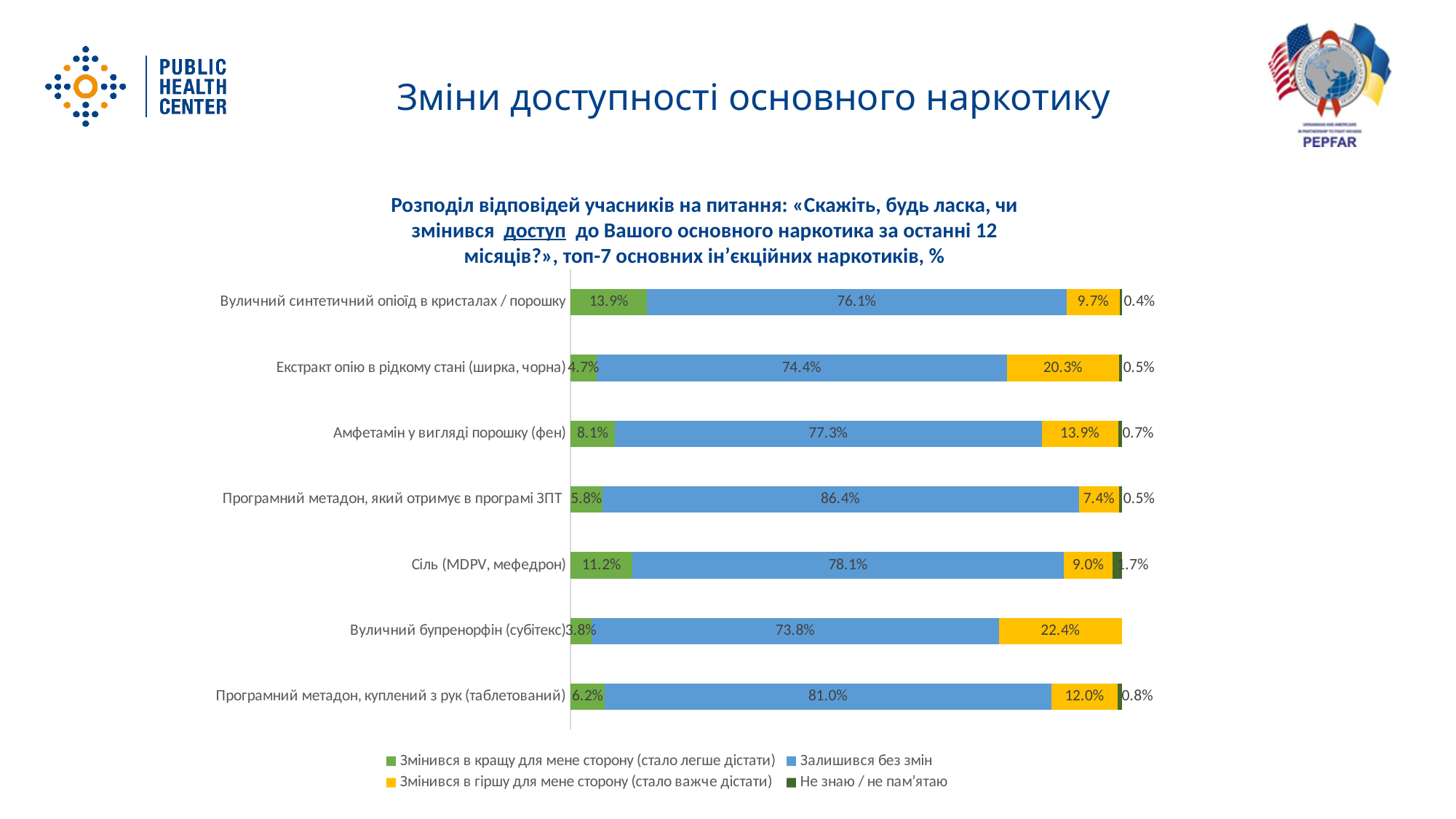
What is the value of 'Не знаю / не пам’ятаю' for 'Програмний метадон, куплений з рук (таблетований)'? 0.8% What is the value of 'Змінився в кращу для мене сторону (стало легше дістати)' for 'Сіль (MDPV, мефедрон)'? 11.2% Which drug category has the lowest share of 'Змінився в кращу для мене сторону (стало легше дістати)' responses? Вуличний бупренорфін (субітекс) Which colour represents the series 'Залишився без змін' in the chart? Blue What is the difference between the 'Змінився в гіршу для мене сторону' values for 'Екстракт опію в рідкому стані (ширка, чорна)' and 'Вуличний синтетичний опіоїд в кристалах / порошку'? 10.6% What is the value of 'Змінився в гіршу для мене сторону (стало важче дістати)' for 'Вуличний бупренорфін (субітекс)'? 22.4% Which drug category has the highest share of 'Залишився без змін' responses? Програмний метадон, який отримує в програмі ЗПТ How many drug categories are plotted in the chart? 7 Which has a larger 'Змінився в кращу для мене сторону' value: 'Вуличний синтетичний опіоїд в кристалах / порошку' or 'Амфетамін у вигляді порошку (фен)'? Вуличний синтетичний опіоїд в кристалах / порошку What type of chart is shown on the slide? Stacked bar chart What share of respondents using 'Програмний метадон, який отримує в програмі ЗПТ' answered 'Залишився без змін'? 86.4% How many series does the legend list? 4